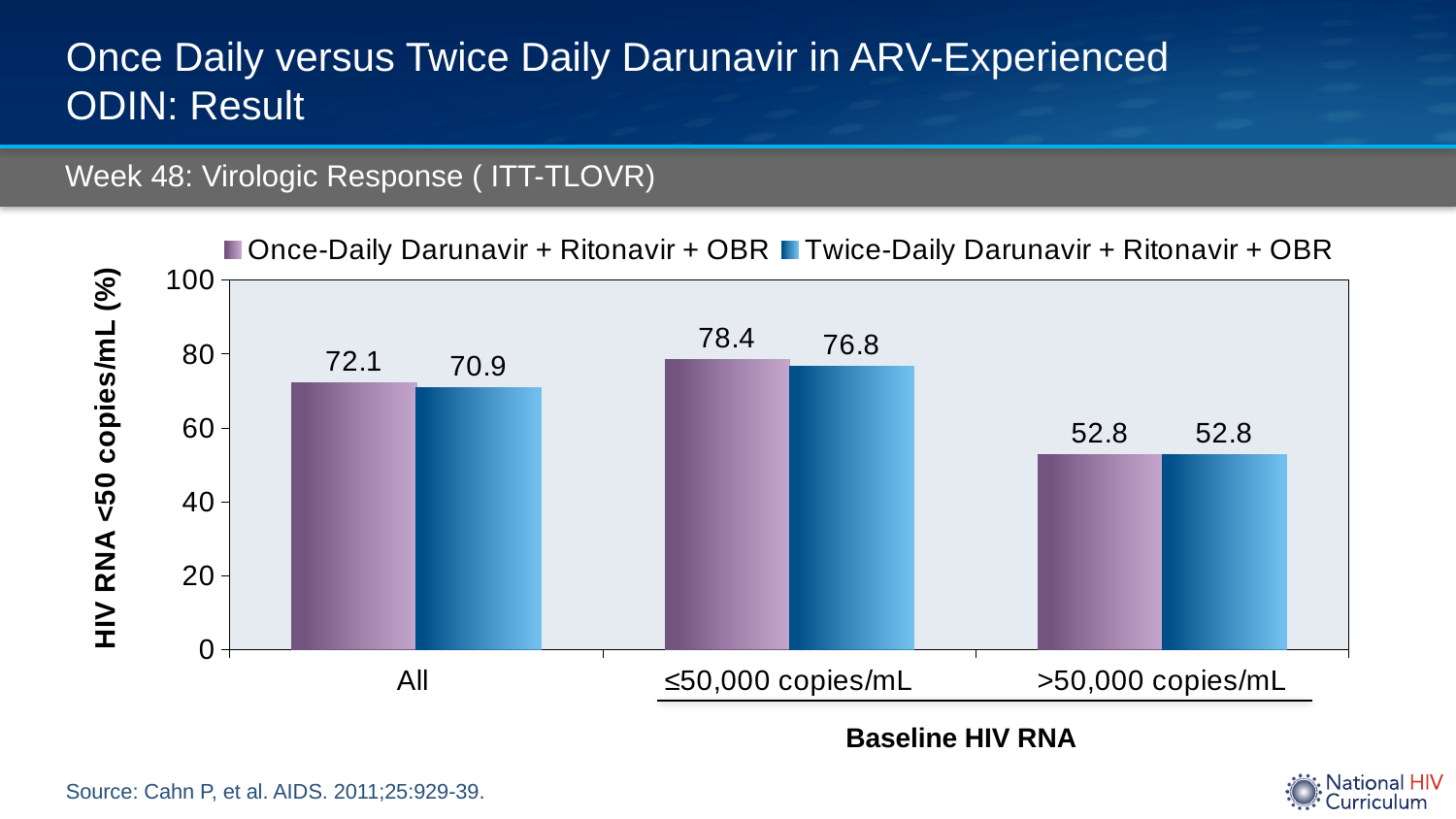
In the ≤50,000 copies/mL group, which series has the larger value, Once-Daily or Twice-Daily Darunavir + Ritonavir + OBR? Once-Daily Darunavir + Ritonavir + OBR What is the difference between the Once-Daily and Twice-Daily values in the ≤50,000 copies/mL group? 1.6 What is the value for Twice-Daily Darunavir + Ritonavir + OBR in the ≤50,000 copies/mL group? 76.8 Which baseline HIV RNA category has the highest value for Once-Daily Darunavir + Ritonavir + OBR? ≤50,000 copies/mL Which baseline HIV RNA category has the lowest value for Twice-Daily Darunavir + Ritonavir + OBR? >50,000 copies/mL What is the value for Once-Daily Darunavir + Ritonavir + OBR in the >50,000 copies/mL group? 52.8 Is the value for Twice-Daily Darunavir + Ritonavir + OBR in the >50,000 copies/mL group greater or less than 60? less What kind of chart is shown on the slide? Bar chart How many baseline HIV RNA categories are shown on the x axis? 3 What is the difference between the Once-Daily and Twice-Daily values in the All group? 1.2 What is the value for Once-Daily Darunavir + Ritonavir + OBR in the All group? 72.1 How many series does the legend list? 2